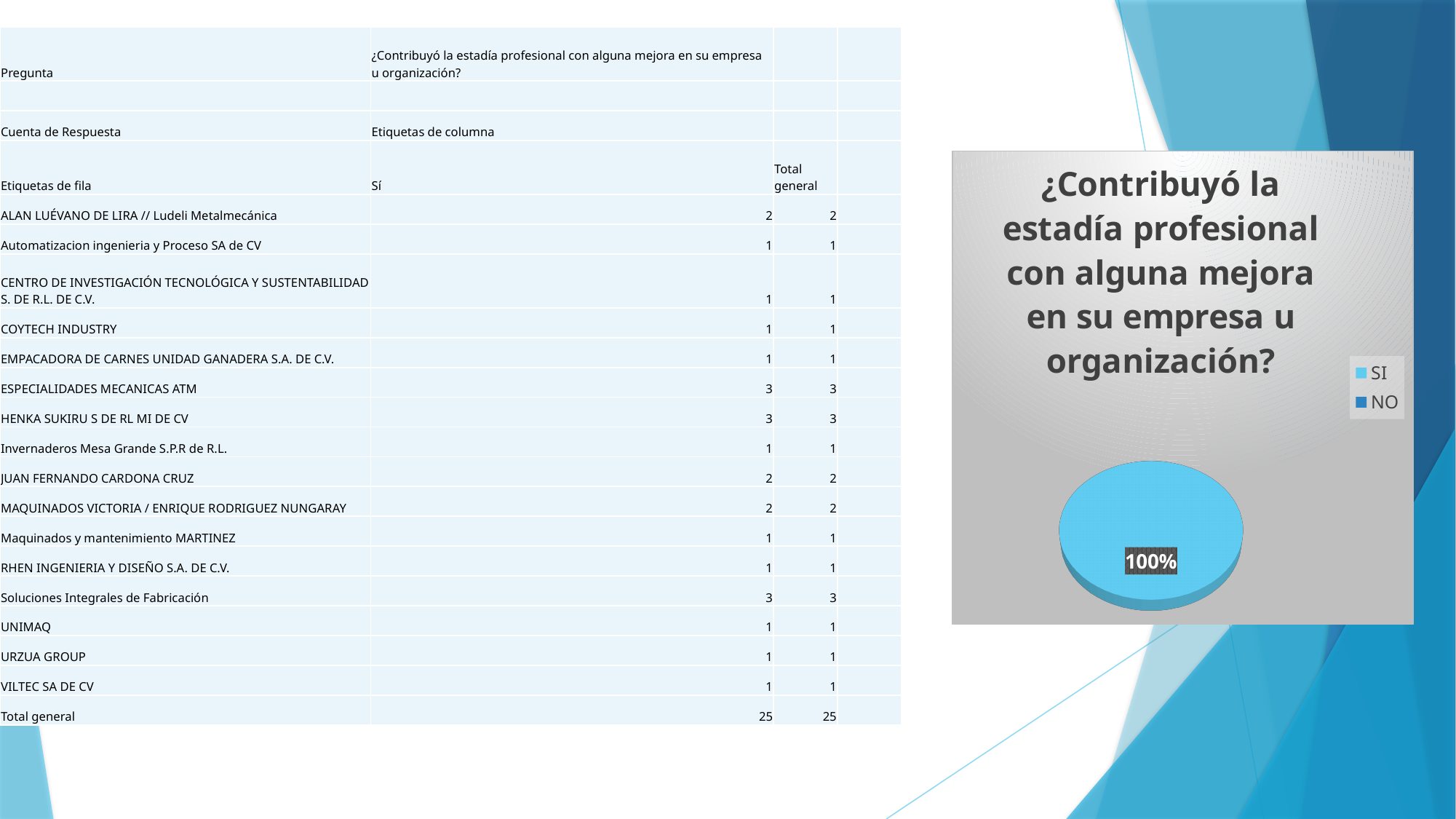
What is the title of the pie chart? ¿Contribuyó la estadía profesional con alguna mejora en su empresa u organización? What kind of chart is shown on the right side of the slide? pie chart Which of the two categories, SI or NO, has the larger share in the pie chart? SI How many entries does the legend of the pie chart list? 2 What share of the pie chart does the SI slice represent? 100% Which category has the largest slice in the pie chart? SI What are the two legend entries of the pie chart? SI and NO Is the share of the SI slice in the pie chart greater or less than 50%? greater What is the data label printed on the pie chart slice? 100%